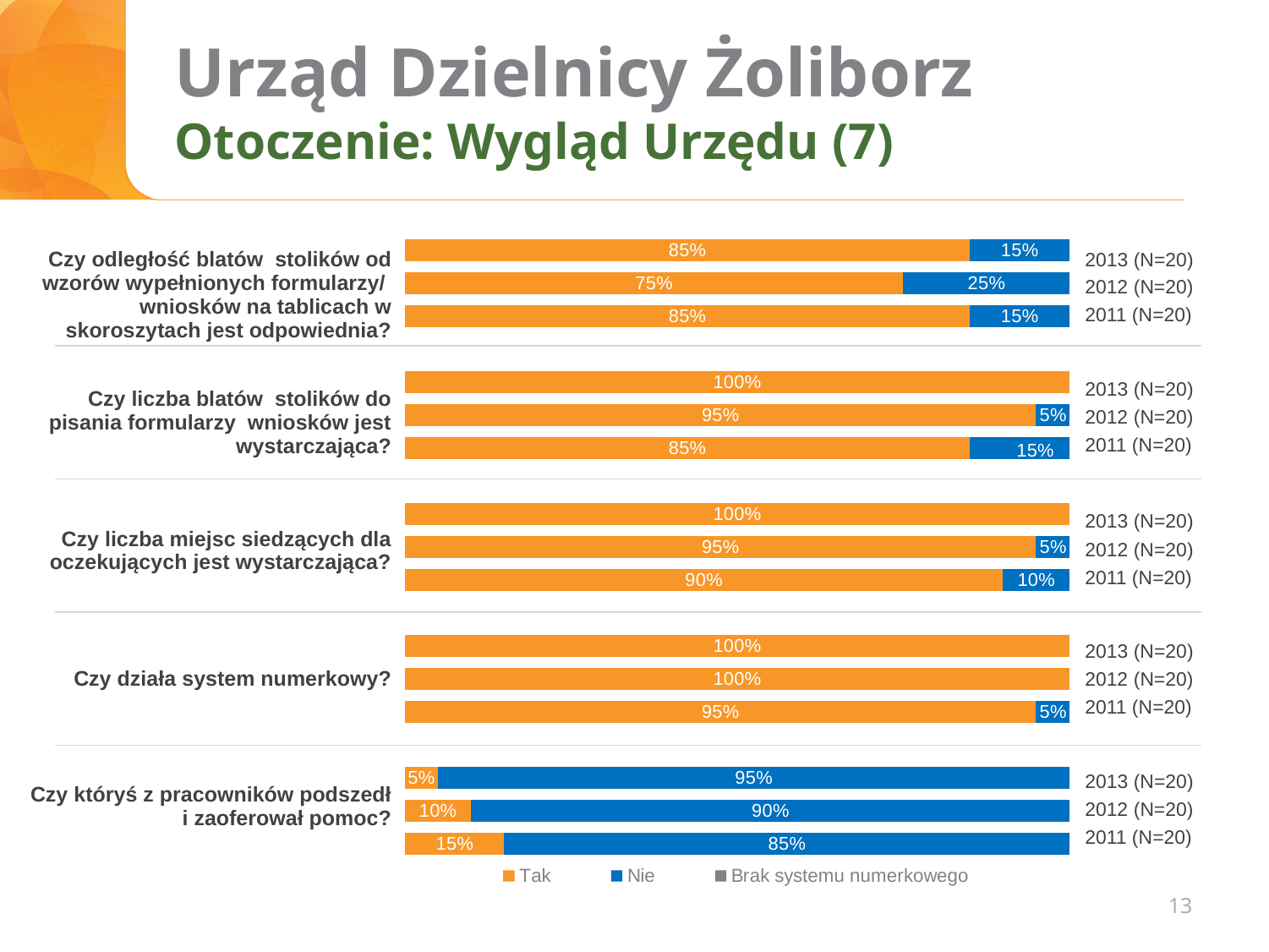
For "Czy odległość blatów stolików od wzorów wypełnionych formularzy/wniosków na tablicach w skoroszytach jest odpowiednia?", which year has the lowest "Tak" share? 2012 (N=20) For "Czy któryś z pracowników podszedł i zaoferował pomoc?", does the "Nie" share rise or fall from 2011 to 2013? rise For "Czy działa system numerkowy?", is the "Tak" share in 2012 larger or smaller than in 2011? larger What percentage answered "Tak" in 2013 for "Czy odległość blatów stolików od wzorów wypełnionych formularzy/wniosków na tablicach w skoroszytach jest odpowiednia?"? 85% What is the difference between the "Tak" share in 2013 and in 2011 for "Czy liczba blatów stolików do pisania formularzy wniosków jest wystarczająca?"? 15% What percentage answered "Tak" in 2011 for "Czy liczba blatów stolików do pisania formularzy wniosków jest wystarczająca?"? 85% What percentage answered "Tak" in 2013 for "Czy któryś z pracowników podszedł i zaoferował pomoc?"? 5% For "Czy któryś z pracowników podszedł i zaoferował pomoc?", which year has the highest "Tak" share? 2011 (N=20) What kind of chart is shown on the slide? Stacked bar chart What percentage answered "Nie" in 2012 for "Czy odległość blatów stolików od wzorów wypełnionych formularzy/wniosków na tablicach w skoroszytach jest odpowiednia?"? 25% How many series does the legend list? 3 What percentage answered "Nie" in 2011 for "Czy liczba miejsc siedzących dla oczekujących jest wystarczająca?"? 10%